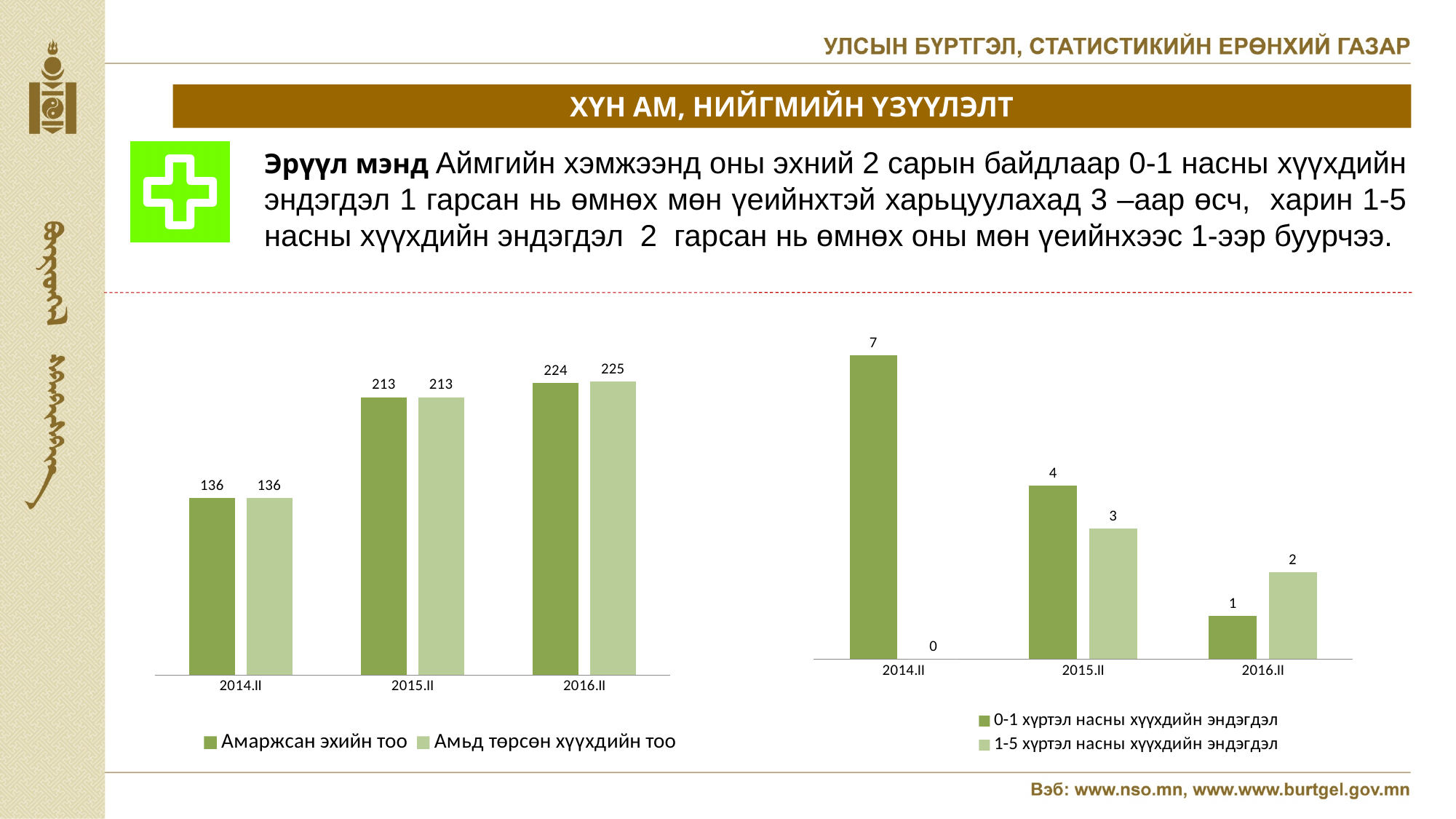
In the left chart, what is the value of Амьд төрсөн хүүхдийн тоо for 2016.II? 225 In the left chart, what is the difference between Амаржсан эхийн тоо in 2016.II and in 2014.II? 88 In the left chart, which year has the lowest value for Амаржсан эхийн тоо? 2014.II How many categories are shown on the x axis of the right chart? 3 In the left chart, what is the value of Амаржсан эхийн тоо for 2015.II? 213 In the right chart, what is the value of 0-1 хүртэл насны хүүхдийн эндэгдэл for 2014.II? 7 How many series does the legend of the left chart list? 2 What type of chart is the right chart? bar chart In the left chart, does the value of Амьд төрсөн хүүхдийн тоо rise or fall from 2014.II to 2016.II? rise In the right chart, which year has the highest value for 0-1 хүртэл насны хүүхдийн эндэгдэл? 2014.II In the right chart, which is larger in 2016.II: 0-1 хүртэл насны хүүхдийн эндэгдэл or 1-5 хүртэл насны хүүхдийн эндэгдэл? 1-5 хүртэл насны хүүхдийн эндэгдэл In the right chart, what is the value of 1-5 хүртэл насны хүүхдийн эндэгдэл for 2015.II? 3